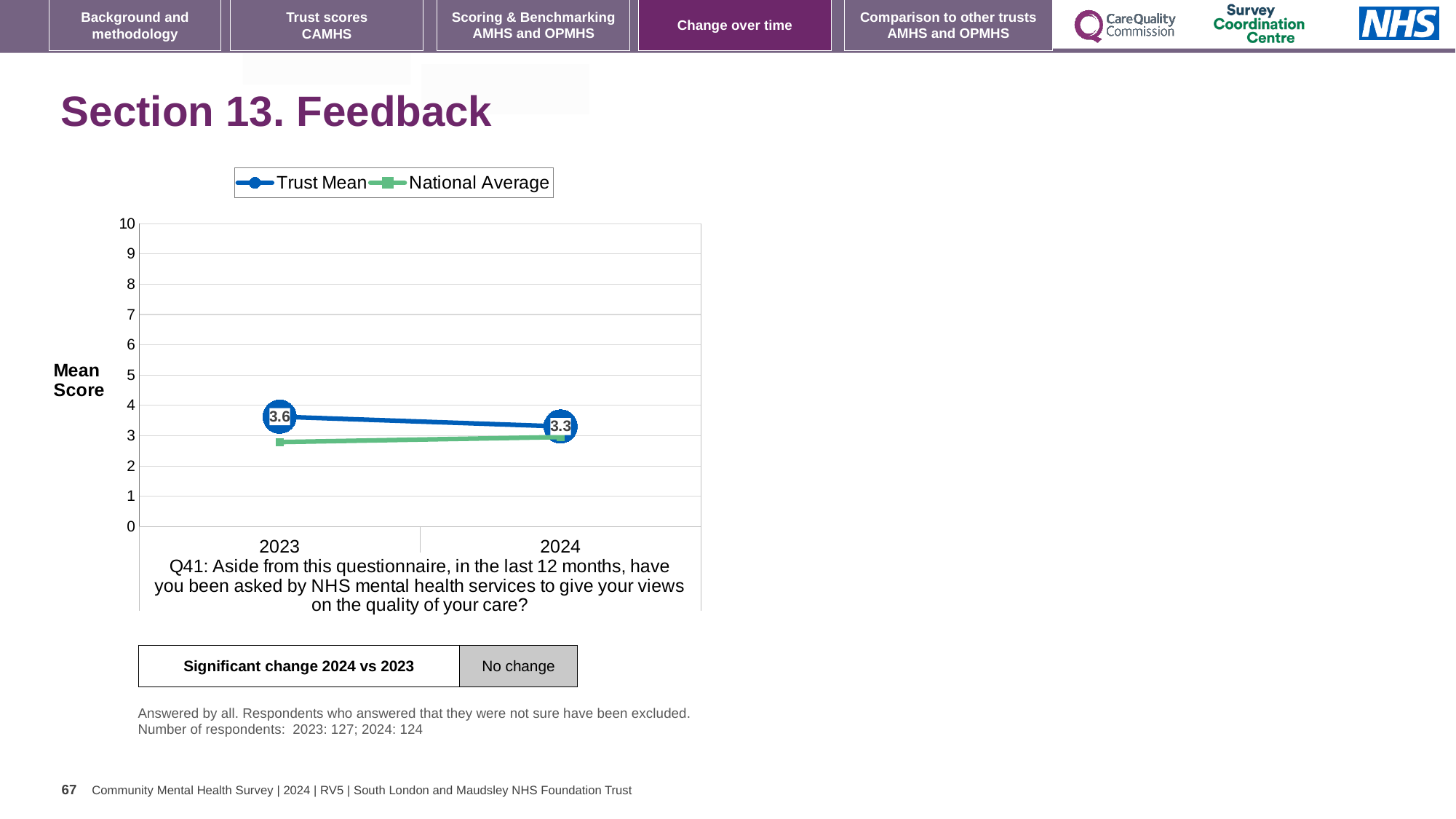
Does the Trust Mean rise or fall from 2023 to 2024? fall What kind of chart is shown on the slide? line chart How many series does the legend list? 2 In which year is the Trust Mean highest? 2023 What is the Trust Mean value for 2023? 3.6 What is the label on the y axis of the chart? Mean Score In 2023, which is larger, the Trust Mean or the National Average? Trust Mean How many years are plotted on the x axis? 2 What is the difference between the Trust Mean in 2023 and in 2024? 0.3 Is the National Average value for 2023 greater or less than 3? less What is the Trust Mean value for 2024? 3.3 Which year has the higher Trust Mean, 2023 or 2024? 2023